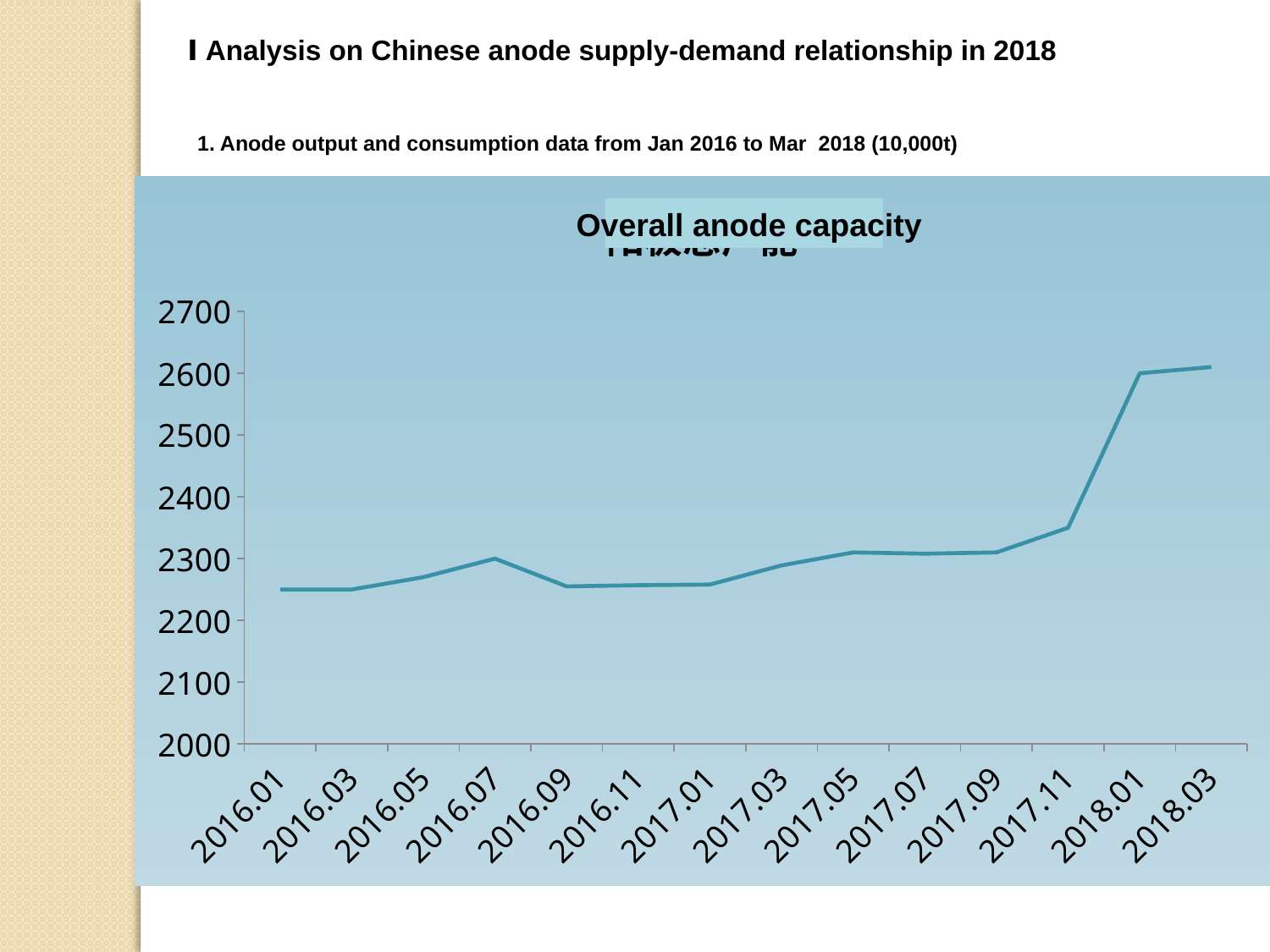
What is the title of the chart? Overall anode capacity Which is larger, the value for 2016.07 or the value for 2016.09? 2016.07 Is the value for 2016.01 greater or less than 2300? less Which is larger, the value for 2018.01 or the value for 2017.11? 2018.01 Is the value for 2018.03 greater or less than 2500? greater What kind of chart is shown on the slide? line chart How many dates are labelled along the x axis of the chart? 14 Is the value for 2016.09 greater or less than 2300? less What is the highest value shown on the y axis of the chart? 2700 Overall, do the values rise or fall from 2016.01 to 2018.03? rise